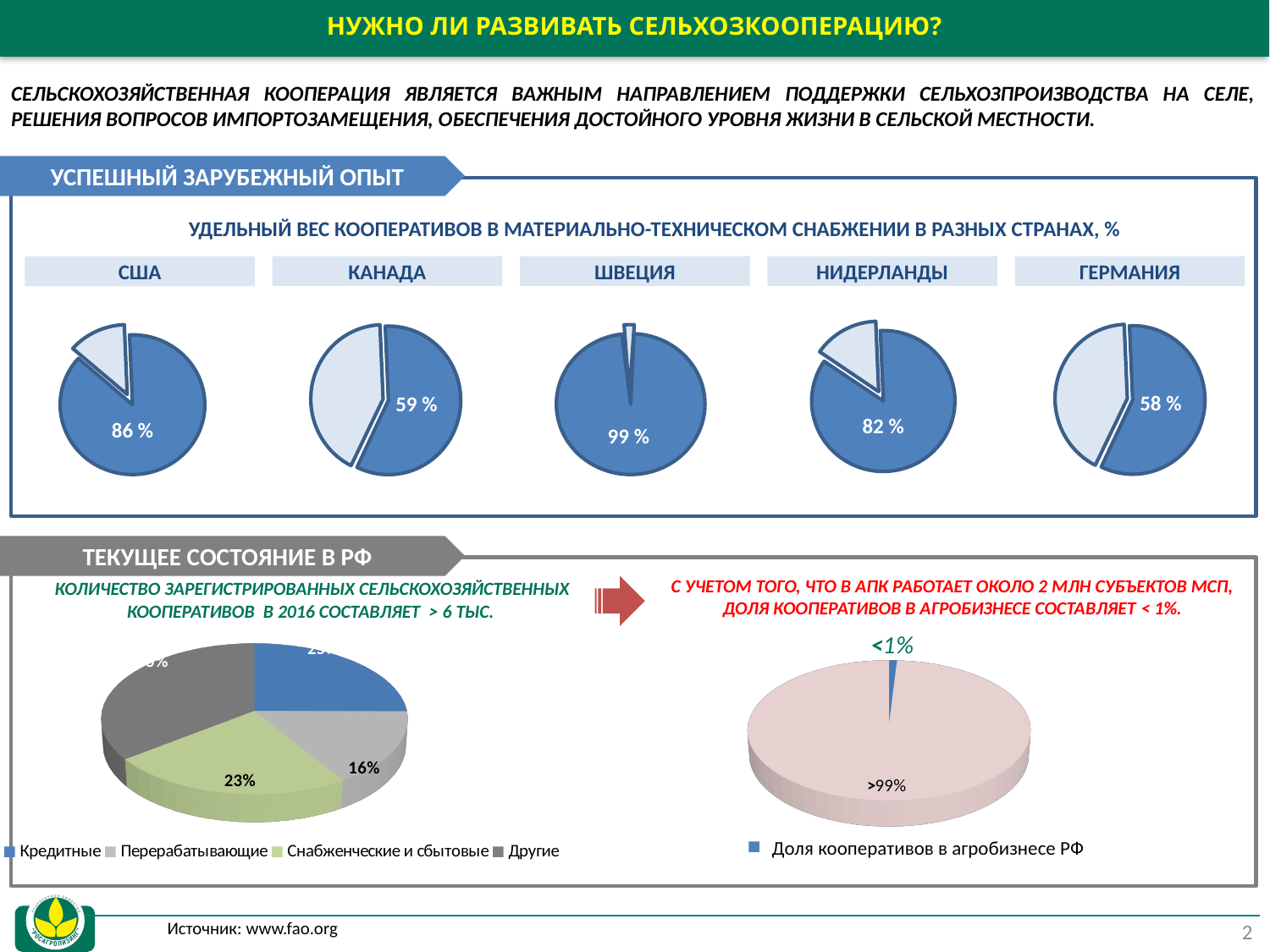
In the top chart group 'Удельный вес кооперативов в материально-техническом снабжении в разных странах, %', how many countries are shown? 5 What kind of chart is used for each country in the top section 'Успешный зарубежный опыт'? Pie chart In the top chart group 'Удельный вес кооперативов в материально-техническом снабжении в разных странах, %', what is the difference between the values for США and Канада? 27 % In the top chart group 'Удельный вес кооперативов в материально-техническом снабжении в разных странах, %', what is the value shown for США? 86 % In the bottom-right pie chart 'Доля кооперативов в агробизнесе РФ', what is the value shown for the small blue slice? <1% In the top chart group 'Удельный вес кооперативов в материально-техническом снабжении в разных странах, %', what is the value shown for Нидерланды? 82 % In the bottom-left pie chart of registered agricultural cooperatives, what is the value shown for the grey slice 'Перерабатывающие'? 16% In the top chart group 'Удельный вес кооперативов в материально-техническом снабжении в разных странах, %', what is the value shown for Швеция? 99 % In the top chart group 'Удельный вес кооперативов в материально-техническом снабжении в разных странах, %', which country has the highest value? Швеция In the top chart group 'Удельный вес кооперативов в материально-техническом снабжении в разных странах, %', what is the value shown for Канада? 59 % In the top chart group 'Удельный вес кооперативов в материально-техническом снабжении в разных странах, %', what is the value shown for Германия? 58 % In the top chart group 'Удельный вес кооперативов в материально-техническом снабжении в разных странах, %', which country has the lowest value? Германия